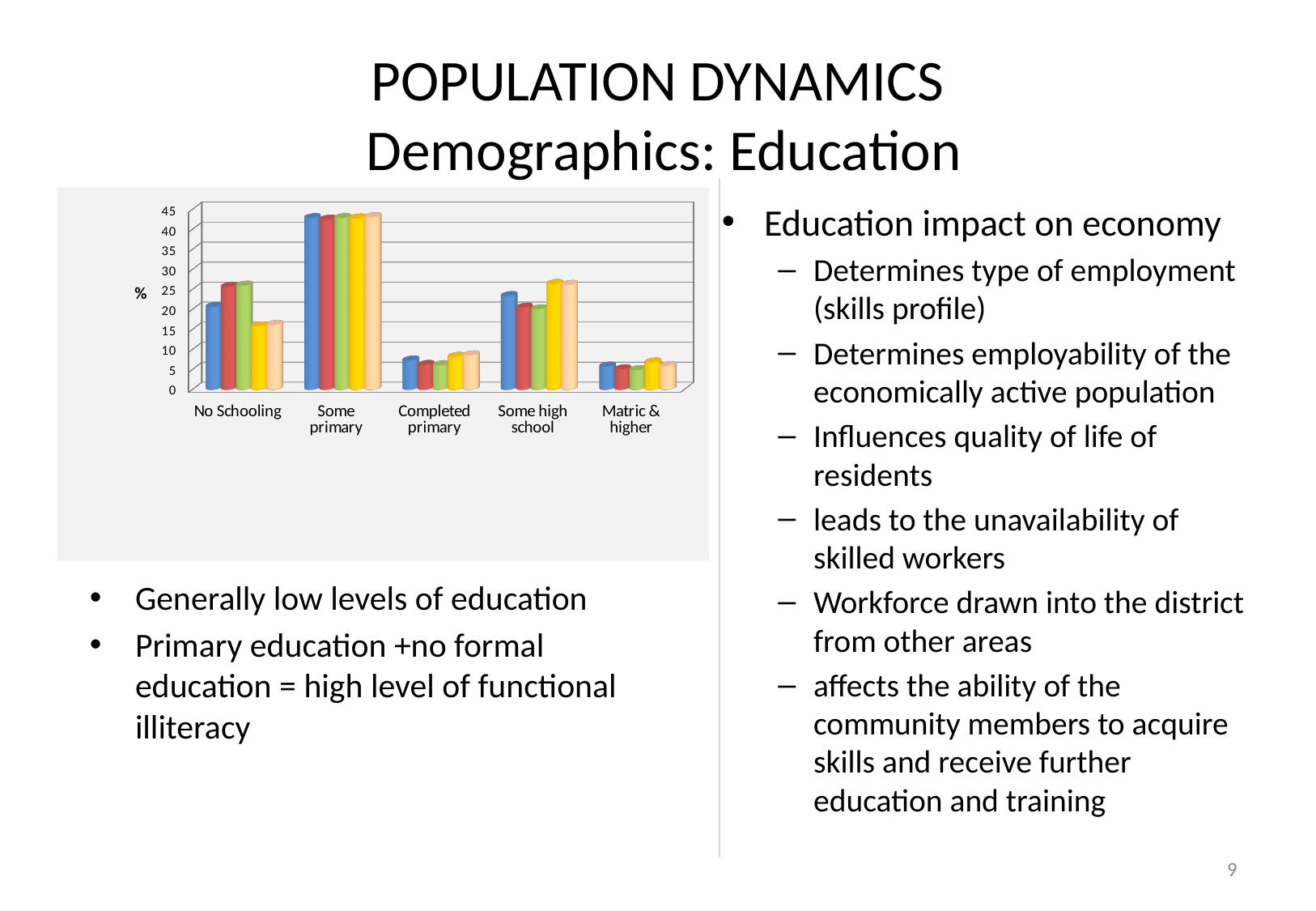
What kind of chart is shown on the slide? bar chart Are the values for Some primary greater or less than 40? greater Which education category has the highest bars in the chart? Some primary Are the values for Some high school greater or less than 15? greater Which category has larger values, Some high school or Completed primary? Some high school How many education categories are shown on the x axis of the chart? 5 Which category has larger values, Some primary or No Schooling? Some primary Are the values for Completed primary greater or less than 10? less What is the label on the vertical axis of the chart? % Which education category has the lowest bars in the chart? Matric & higher